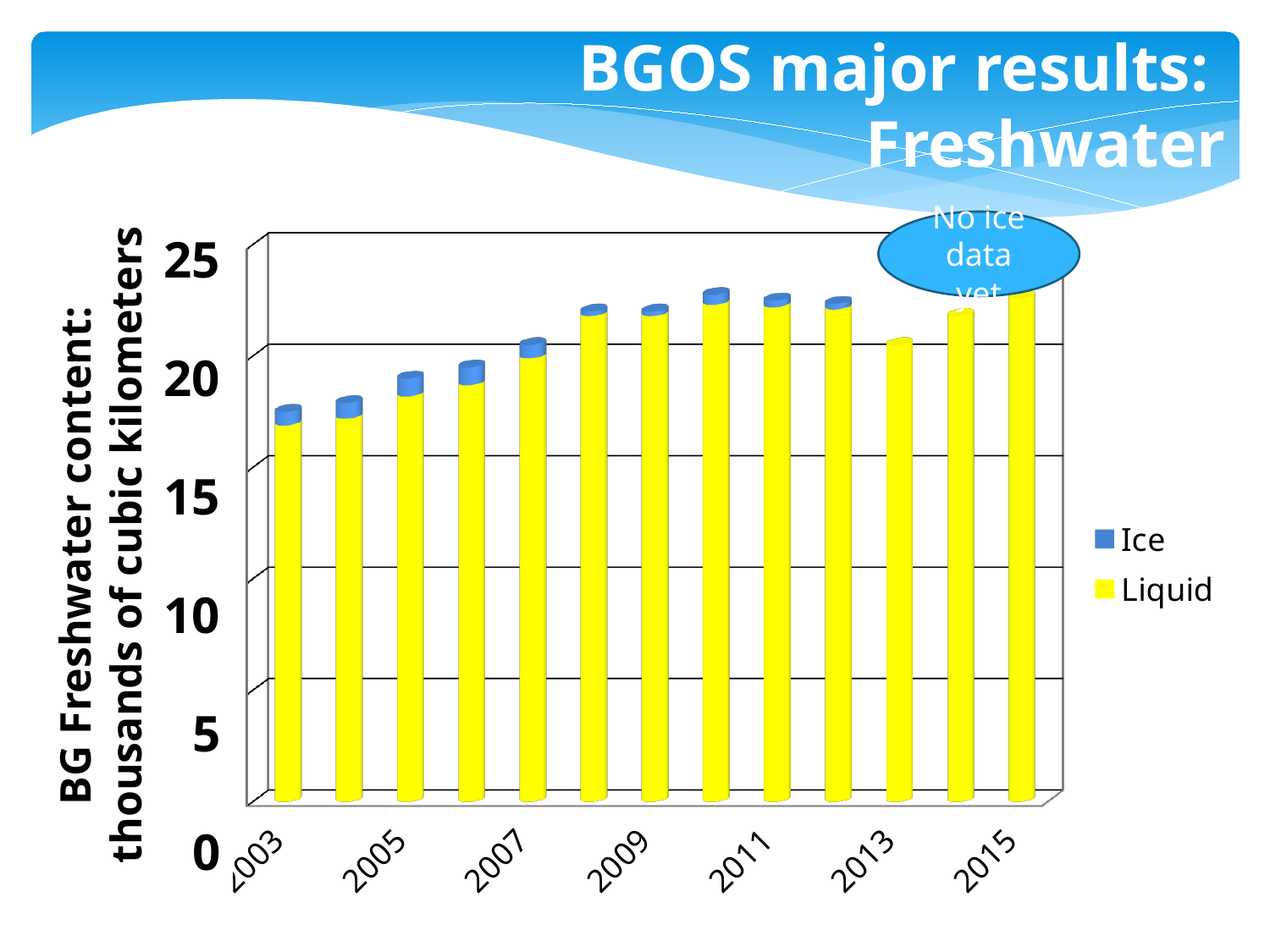
How many series does the legend list? 2 Is the total freshwater content for 2003 greater or less than 15? greater Is the total freshwater content for 2003 greater or less than 20? less What kind of chart is shown on the slide? Stacked bar chart What are the two series named in the legend? Ice and Liquid What is the title of the vertical axis? BG Freshwater content: thousands of cubic kilometers Is the total freshwater content for 2009 greater or less than 20? greater How many bars (years) are plotted in the chart? 13 Which year has the larger total freshwater content, 2003 or 2009? 2009 Do the total freshwater content values generally rise or fall from 2003 to 2010? rise Which year has the lowest total freshwater content? 2003